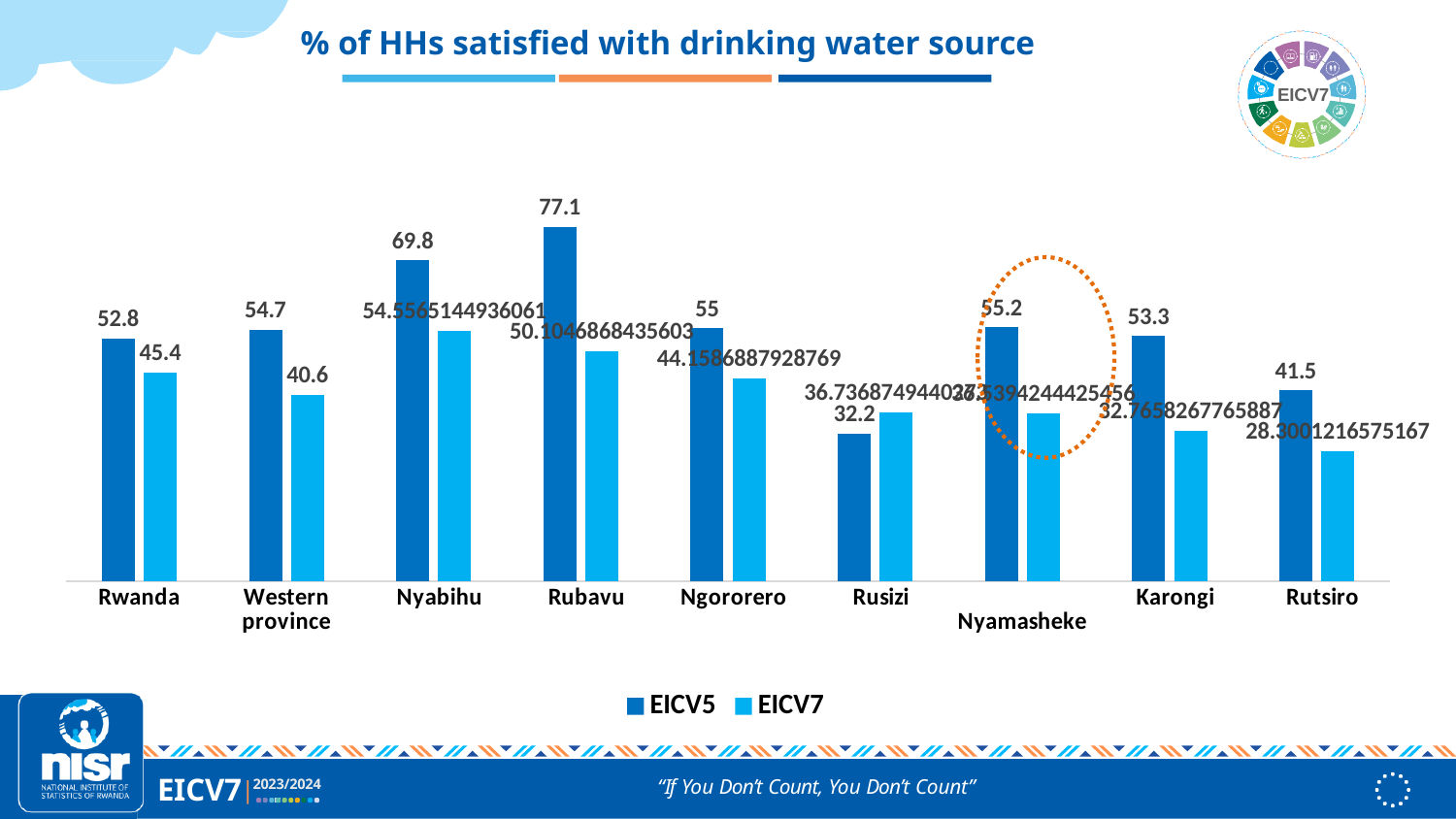
What is the difference between the EICV5 and EICV7 values for Rwanda? 7.4 For Rusizi, which is larger: the EICV5 value or the EICV7 value? EICV7 What is the EICV7 value for Rwanda? 45.4 How many series does the legend list? 2 What is the title of the chart? % of HHs satisfied with drinking water source Which category has the lowest EICV5 value? Rusizi What is the EICV5 value for Rubavu? 77.1 What kind of chart is shown on the slide? bar chart Which category has the highest EICV5 value? Rubavu What is the EICV5 value for Nyabihu? 69.8 Which category has the lowest EICV7 value? Rutsiro How many categories are shown on the x axis? 9